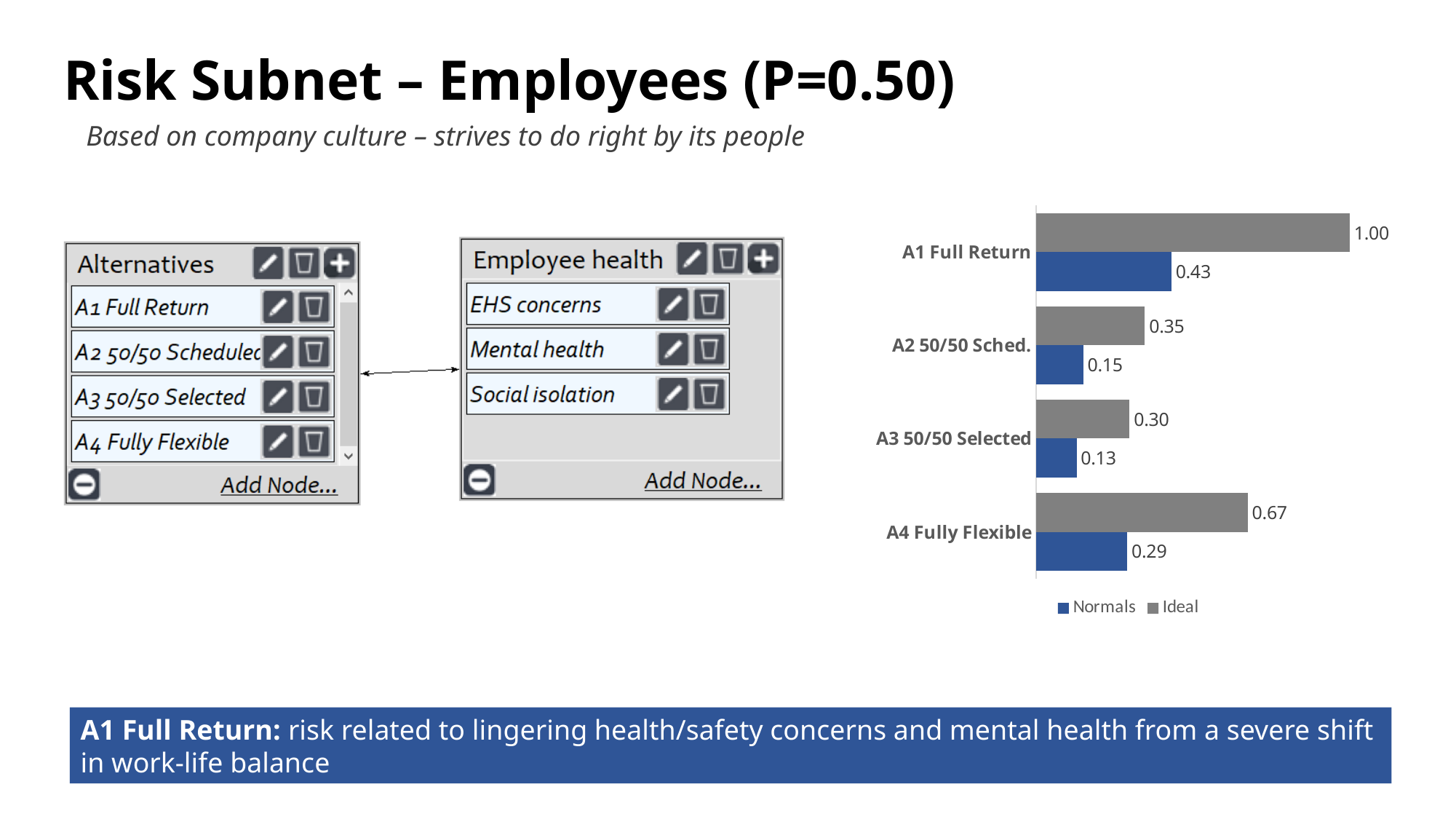
How many categories are shown on the chart? 4 What is the Ideal value for A4 Fully Flexible? 0.67 Which series is shown in blue in the chart? Normals What is the difference between the Ideal and Normals values for A1 Full Return? 0.57 What is the Ideal value for A1 Full Return? 1.00 How many series does the legend list? 2 Which category has the lowest Normals value? A3 50/50 Selected Which category has the highest Ideal value? A1 Full Return What is the Normals value for A3 50/50 Selected? 0.13 What kind of chart is shown on the slide? Bar chart What is the Normals value for A2 50/50 Sched.? 0.15 Which is larger, the Ideal value for A2 50/50 Sched. or the Ideal value for A4 Fully Flexible? A4 Fully Flexible